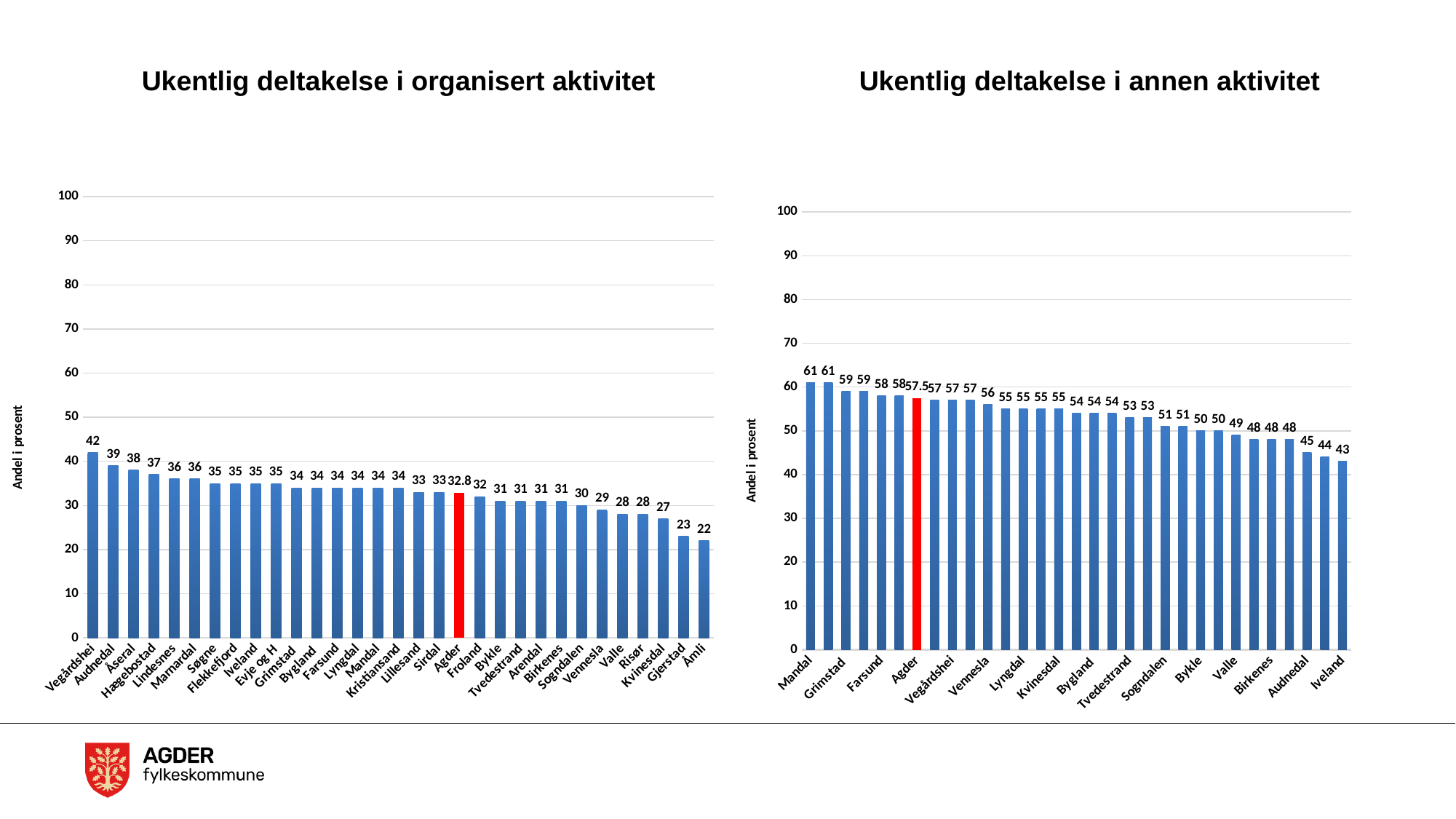
In the chart titled 'Ukentlig deltakelse i organisert aktivitet', what is the value for Agder (the red bar)? 32.8 In the chart titled 'Ukentlig deltakelse i organisert aktivitet', which category has the lowest value? Åmli In the chart titled 'Ukentlig deltakelse i annen aktivitet', what is the difference between the values for Mandal and Iveland? 18 In the chart titled 'Ukentlig deltakelse i organisert aktivitet', what is the value for Vegårdshei? 42 In the chart titled 'Ukentlig deltakelse i organisert aktivitet', which is larger, the value for Audnedal or the value for Gjerstad? Audnedal In the chart titled 'Ukentlig deltakelse i organisert aktivitet', which category has the highest value? Vegårdshei In the chart titled 'Ukentlig deltakelse i organisert aktivitet', what is the difference between the values for Vegårdshei and Åmli? 20 In the chart titled 'Ukentlig deltakelse i organisert aktivitet', do the values rise or fall from left to right along the x axis? fall In the chart titled 'Ukentlig deltakelse i annen aktivitet', what is the value for Mandal? 61 In the chart titled 'Ukentlig deltakelse i annen aktivitet', what is the value for Agder (the red bar)? 57.5 In the chart titled 'Ukentlig deltakelse i annen aktivitet', which category has the lowest value? Iveland What kind of chart is the chart titled 'Ukentlig deltakelse i annen aktivitet'? bar chart